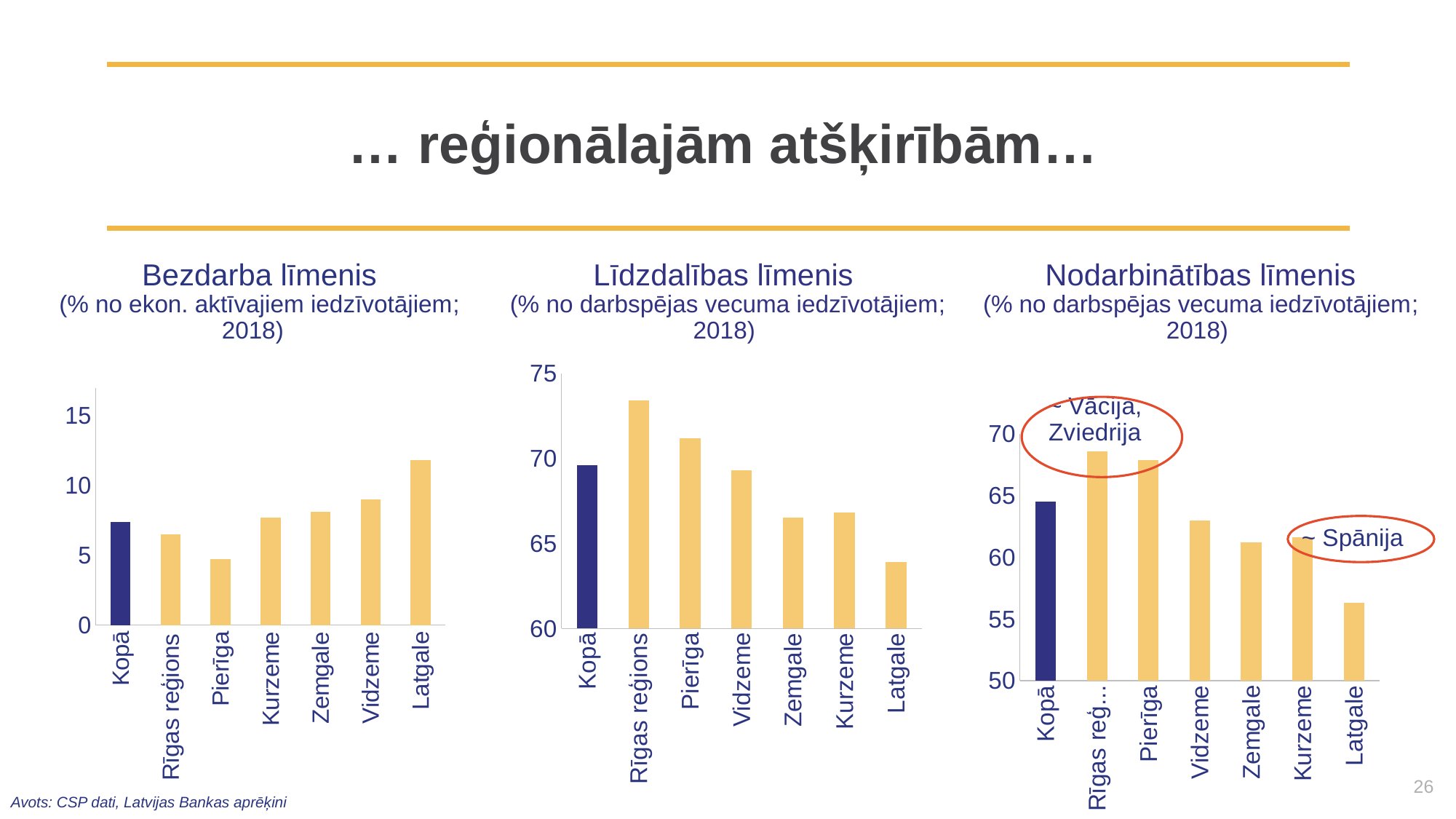
In the 'Nodarbinātības līmenis' chart, which region has the lowest employment rate? Latgale In the 'Līdzdalības līmenis' chart, is the value for Latgale greater or less than 65? less In the 'Bezdarba līmenis' chart, which region has the highest unemployment rate? Latgale In the 'Līdzdalības līmenis' chart, which is larger, the value for Pierīga or the value for Zemgale? Pierīga In the 'Līdzdalības līmenis' chart, which region has the highest participation rate? Rīgas reģions In the 'Līdzdalības līmenis' chart, which region has the lowest participation rate? Latgale In the 'Nodarbinātības līmenis' chart, is the value for Latgale greater or less than 60? less How many categories are shown on the x axis of the 'Nodarbinātības līmenis' chart? 7 In the 'Bezdarba līmenis' chart, is the value for Latgale greater or less than 10? greater What type of chart is the 'Bezdarba līmenis' chart? Bar chart In the 'Bezdarba līmenis' chart, which region has the lowest unemployment rate? Pierīga